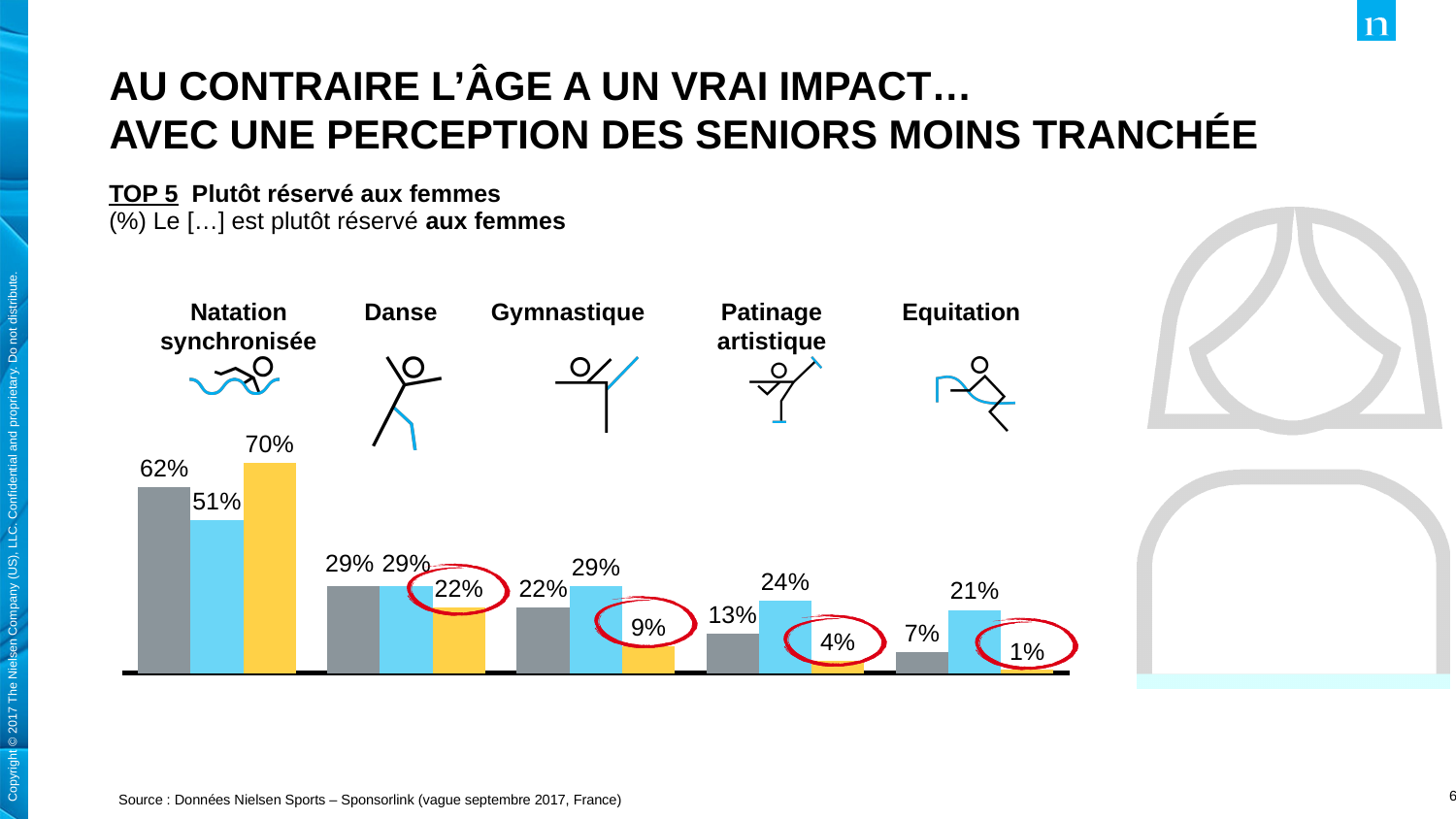
What is the value of the yellow bar for Natation synchronisée? 70% What is the value of the blue bar for Patinage artistique? 24% What is the value of the grey bar for Natation synchronisée? 62% How many bars are shown for each category? 3 What is the difference between the yellow bar and the grey bar for Natation synchronisée? 8% Which category has the lowest grey bar? Equitation What is the value of the yellow bar for Equitation? 1% How many categories are shown in the chart? 5 Which category has the highest yellow bar? Natation synchronisée What is the value of the yellow bar for Gymnastique? 9% Which is larger for Patinage artistique, the grey bar or the blue bar? the blue bar What kind of chart is shown on the slide? bar chart